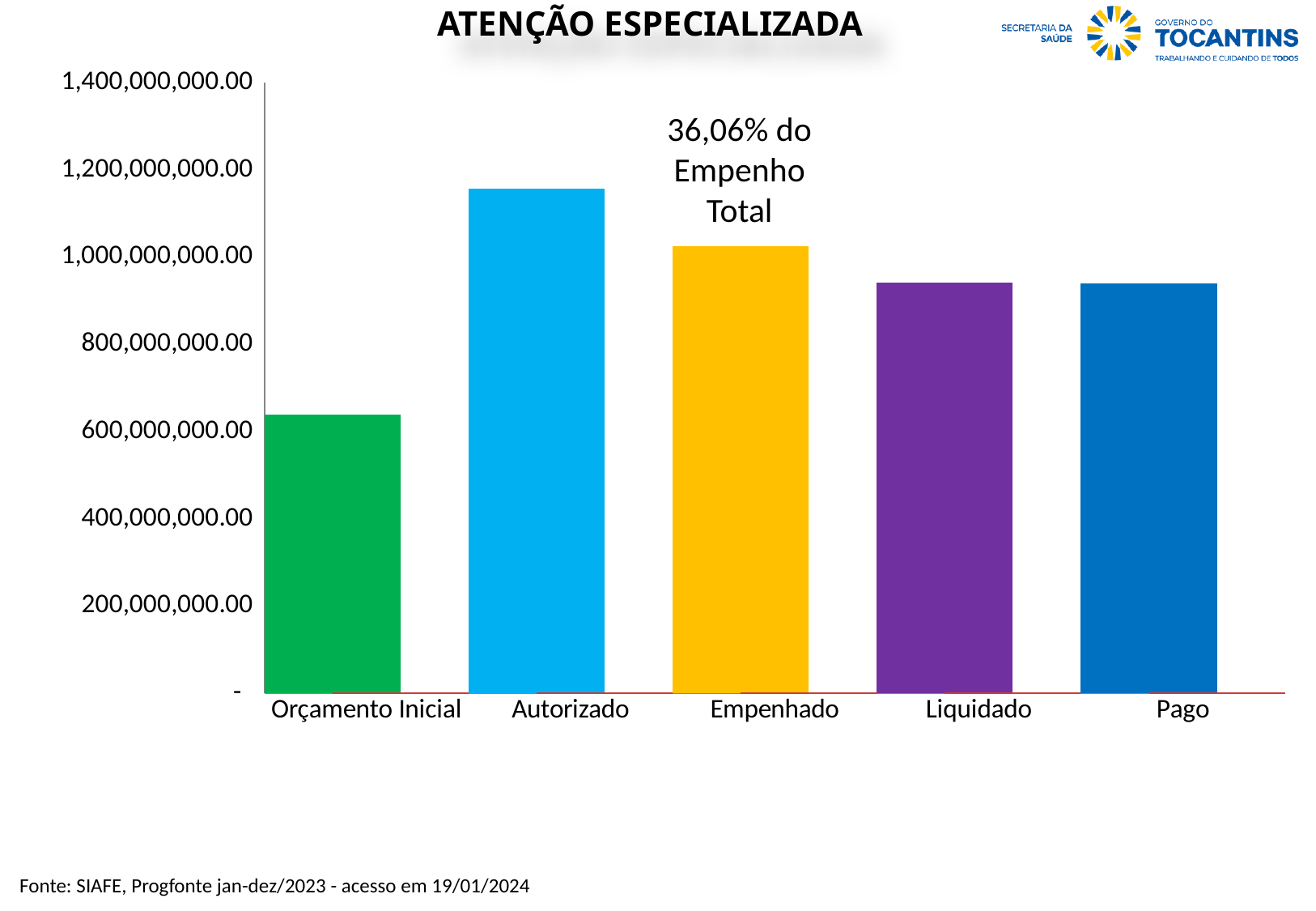
Which category has the highest bar in the chart? Autorizado Is the value for Pago greater or less than 800,000,000.00? greater Is the value for Autorizado greater or less than 1,000,000,000.00? greater Which is larger, the value for Autorizado or the value for Empenhado? Autorizado What text annotation is printed above the Empenhado bar? 36,06% do Empenho Total What kind of chart is shown on the slide? bar chart What is the title of the chart? ATENÇÃO ESPECIALIZADA Which is larger, the value for Orçamento Inicial or the value for Pago? Pago Which category has the lowest bar in the chart? Orçamento Inicial Is the value for Liquidado greater or less than 1,000,000,000.00? less How many categories are shown on the x axis of the chart? 5